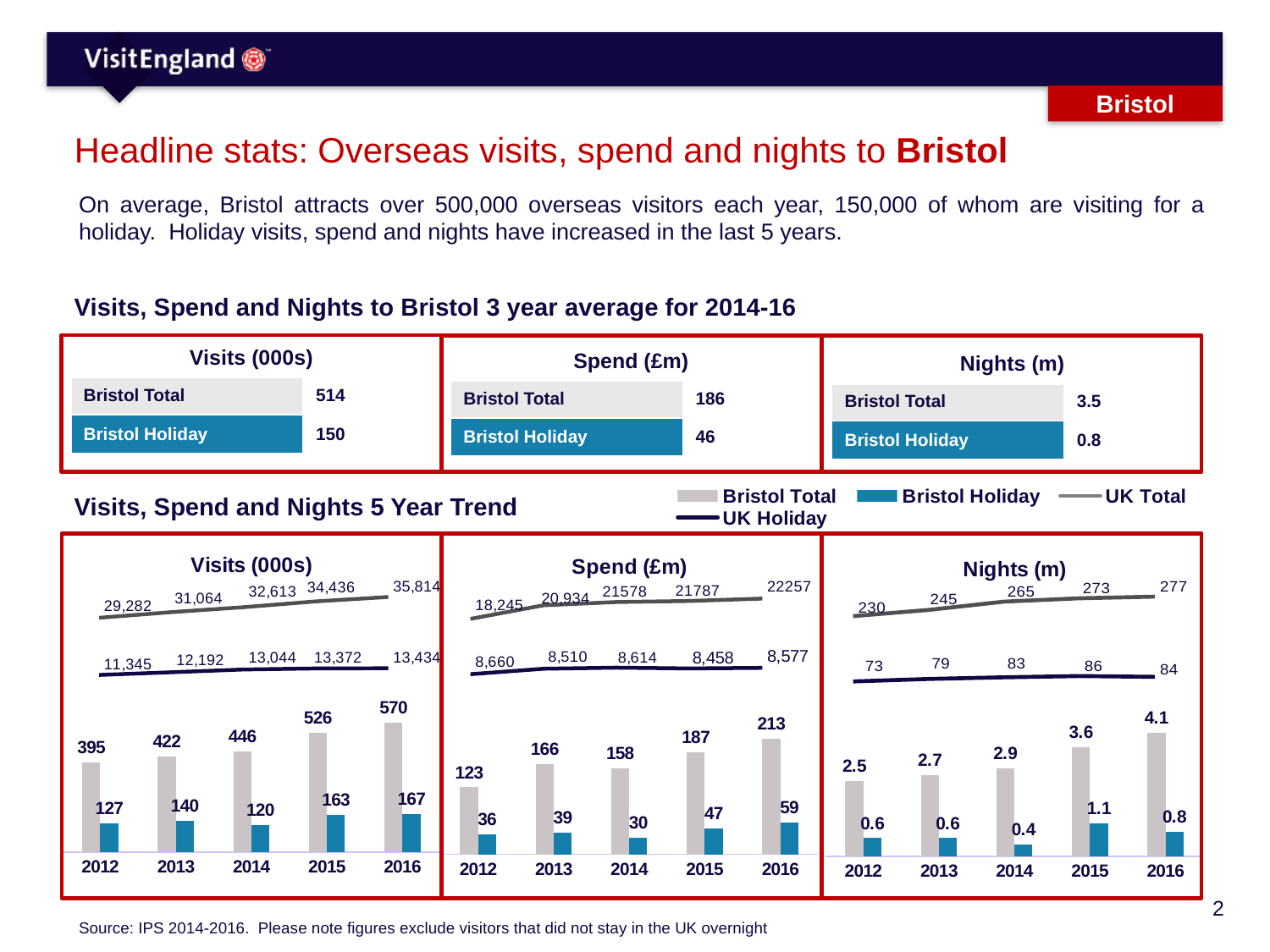
In the Visits (000s) 5 year trend chart, what is the difference between the UK Holiday values for 2016 and 2012? 2,089 In the Spend (£m) 5 year trend chart, what is the Bristol Holiday value for 2014? 30 In the Visits (000s) 5 year trend chart, how many years are shown on the x axis? 5 In the Spend (£m) 5 year trend chart, which year has the highest Bristol Total value? 2016 In the Nights (m) 5 year trend chart, what is the difference between the Bristol Total values for 2016 and 2012? 1.6 In the Visits (000s) 5 year trend chart, what is the Bristol Total value for 2016? 570 In the Nights (m) 5 year trend chart, what is the UK Total value for 2015? 273 How many series does the legend for the 5 Year Trend charts list? 4 In the Nights (m) 5 year trend chart, does the Bristol Total value rise or fall from 2012 to 2016? rise In the Spend (£m) 5 year trend chart, is the Bristol Holiday value larger in 2013 or in 2015? 2015 What colour are the Bristol Holiday bars in the 5 Year Trend charts? Blue In the Visits (000s) 5 year trend chart, which year has the lowest Bristol Holiday value? 2014